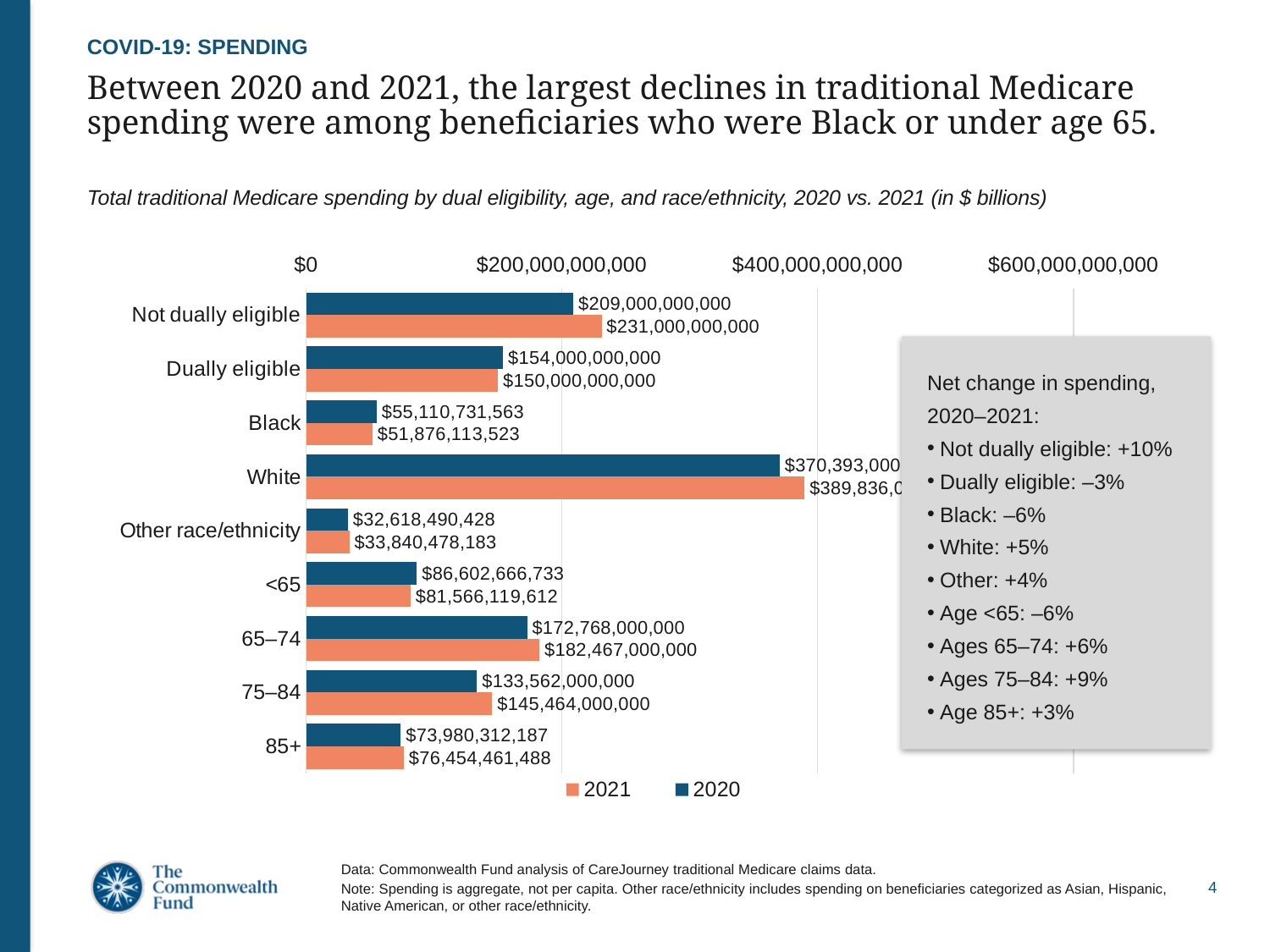
Which colour represents 2020 in the chart? Blue What was total traditional Medicare spending for beneficiaries who were not dually eligible in 2021? $231,000,000,000 What was total traditional Medicare spending for beneficiaries aged 75–84 in 2021? $145,464,000,000 What was total traditional Medicare spending for Black beneficiaries in 2020? $55,110,731,563 What kind of chart is shown on the slide? Bar chart How many categories are shown on the chart? 9 How many series does the legend list? 2 How much higher was spending for not dually eligible beneficiaries in 2021 than in 2020? $22,000,000,000 Is the 2021 spending value for White beneficiaries greater or less than $200,000,000,000? greater Which category had the lowest traditional Medicare spending in 2021? Other race/ethnicity For dually eligible beneficiaries, which year had higher spending, 2020 or 2021? 2020 Which category had the highest traditional Medicare spending in 2020? White